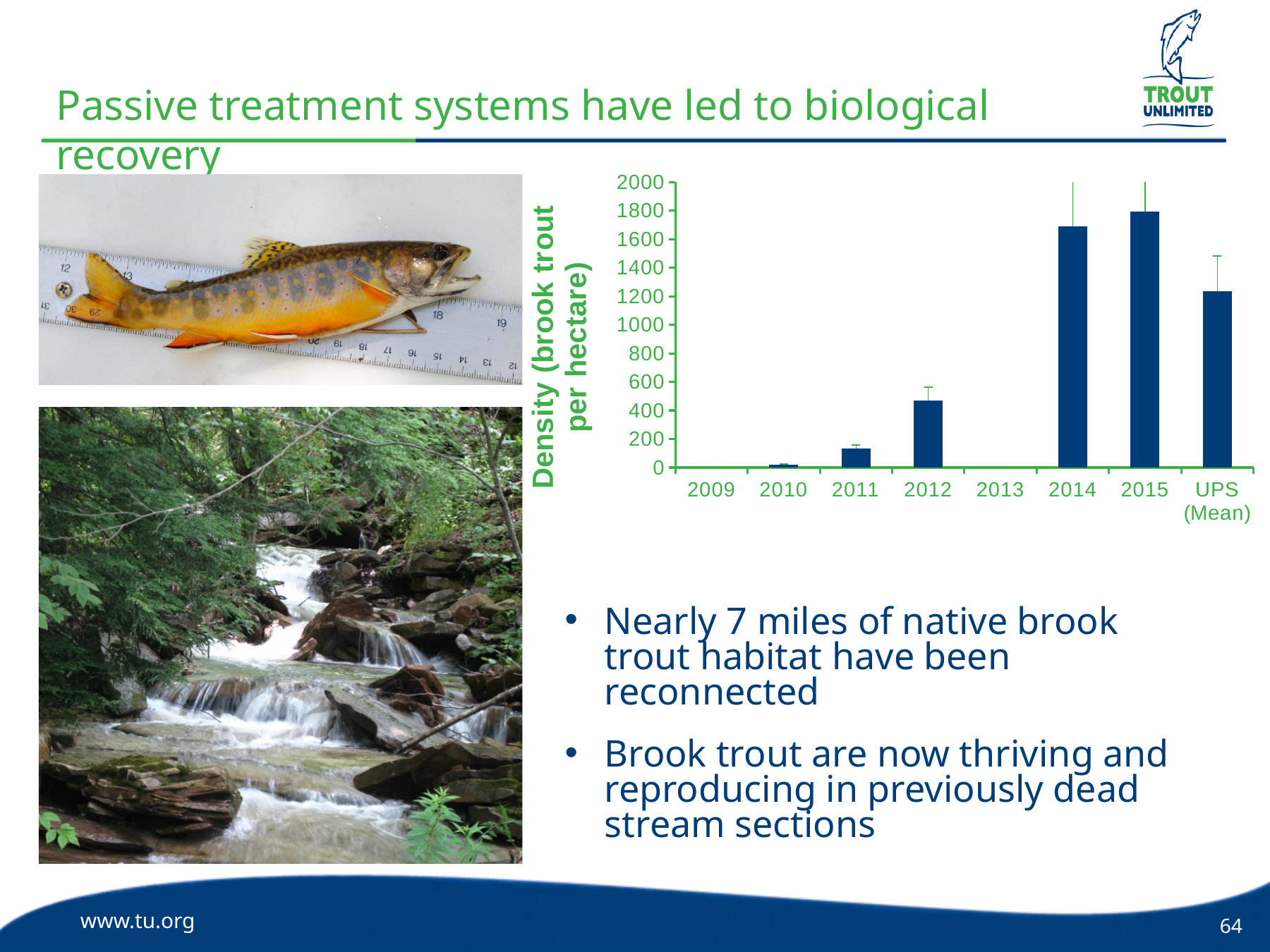
Is the value for 2015 greater or less than 1600? greater What is the label of the y axis of the chart? Density (brook trout per hectare) Is the value for UPS (Mean) greater or less than 1000? greater Is the value for 2012 greater or less than 600? less Which is larger, the value for 2011 or the value for 2012? 2012 Which is larger, the value for 2014 or the value for UPS (Mean)? 2014 Do the brook trout density values generally rise or fall from 2009 to 2015? rise What kind of chart is shown on the slide? bar chart Which category has the highest brook trout density in the chart? 2015 How many categories are shown on the x axis of the chart? 8